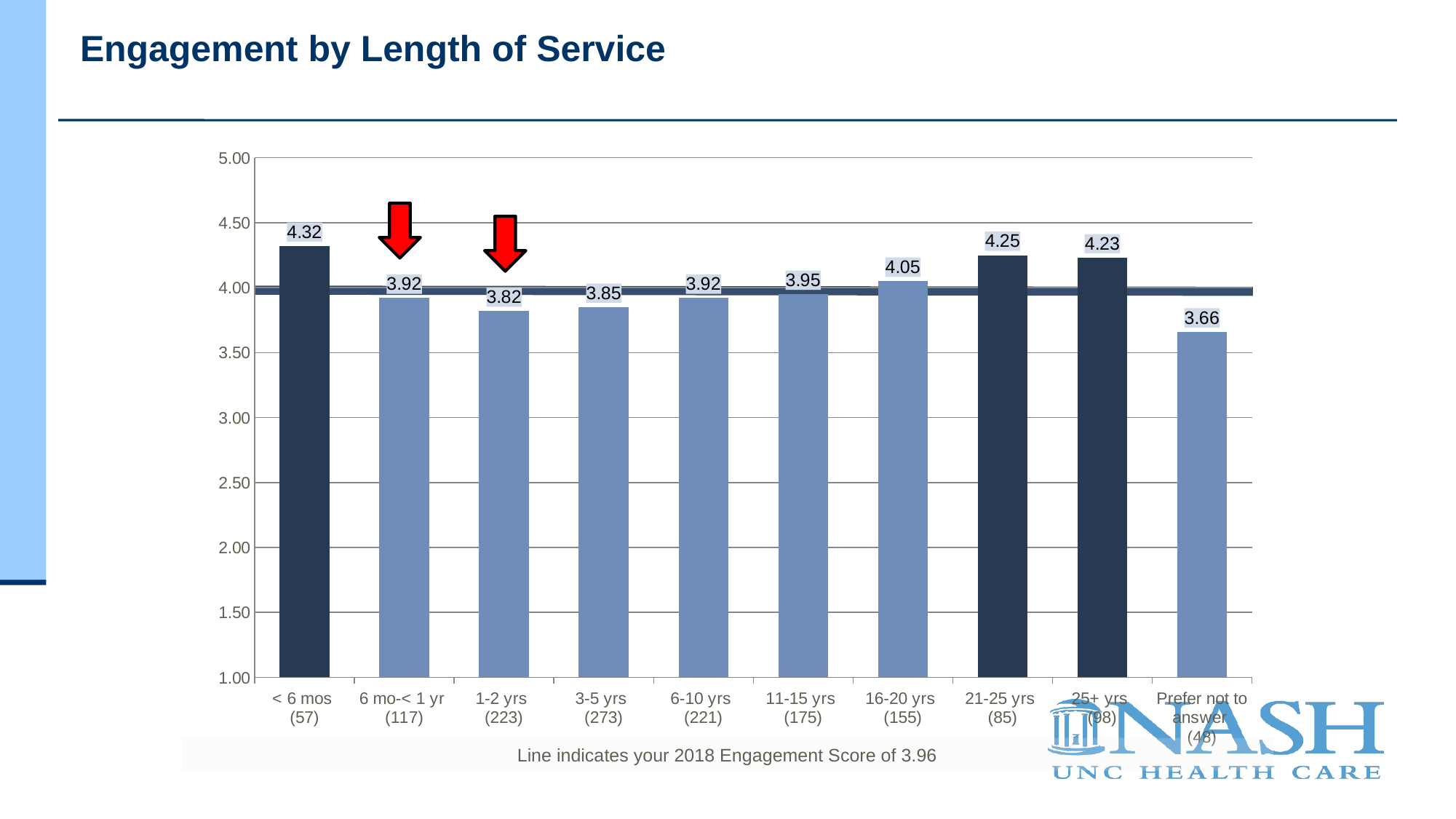
What is the engagement score for the 1-2 yrs group? 3.82 What is the engagement score for the Prefer not to answer group? 3.66 Is the engagement score for the 21-25 yrs group greater or less than 4.00? greater What is the difference between the engagement scores of the < 6 mos group and the 1-2 yrs group? 0.50 Which group has the lowest engagement score? Prefer not to answer How many length-of-service categories are shown on the chart? 10 What is the engagement score for the 16-20 yrs group? 4.05 Which has a higher engagement score, the 3-5 yrs group or the 11-15 yrs group? 11-15 yrs What 2018 Engagement Score does the horizontal line on the chart indicate? 3.96 What is the engagement score for the < 6 mos group? 4.32 Which length-of-service group has the highest engagement score? < 6 mos What kind of chart is shown on the slide? Bar chart